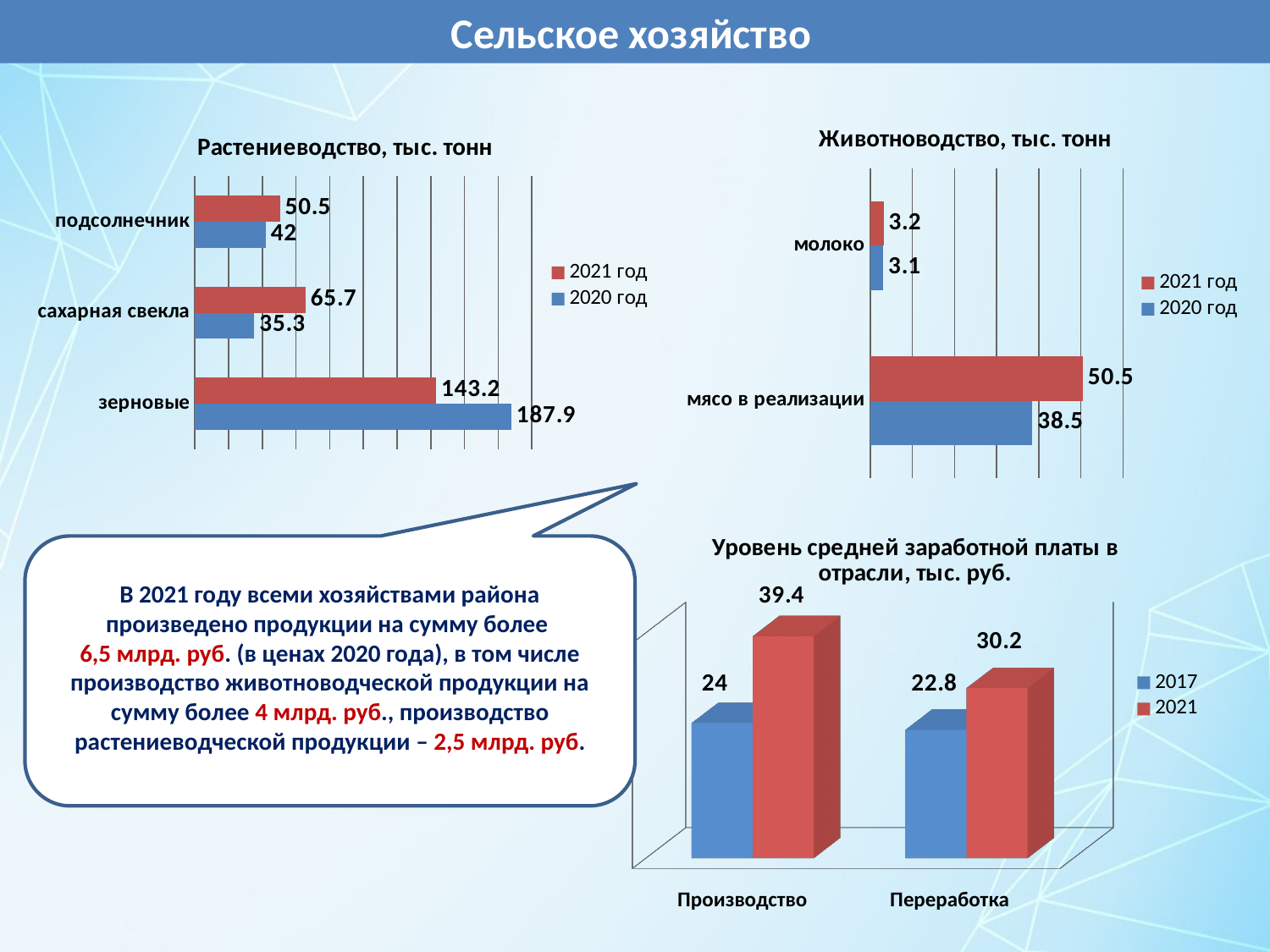
In the chart "Уровень средней заработной платы в отрасли, тыс. руб.", what is the value for Производство in 2021? 39.4 In the chart "Растениеводство, тыс. тонн", which category has the highest value for 2021 год? зерновые In the chart "Растениеводство, тыс. тонн", what is the value for сахарная свекла in 2021 год? 65.7 In the chart "Животноводство, тыс. тонн", what is the value for молоко in 2021 год? 3.2 In the chart "Уровень средней заработной платы в отрасли, тыс. руб.", what is the difference between the 2021 and 2017 values for Переработка? 7.4 In the chart "Растениеводство, тыс. тонн", how many categories are shown? 3 In the chart "Животноводство, тыс. тонн", which is larger for мясо в реализации: the 2021 год value or the 2020 год value? 2021 год In the chart "Животноводство, тыс. тонн", what is the value for мясо в реализации in 2020 год? 38.5 What kind of chart is "Уровень средней заработной платы в отрасли, тыс. руб."? bar chart In the chart "Растениеводство, тыс. тонн", what is the value for зерновые in 2020 год? 187.9 In the chart "Животноводство, тыс. тонн", how many series does the legend list? 2 In the chart "Растениеводство, тыс. тонн", what is the difference between the 2021 год and 2020 год values for подсолнечник? 8.5